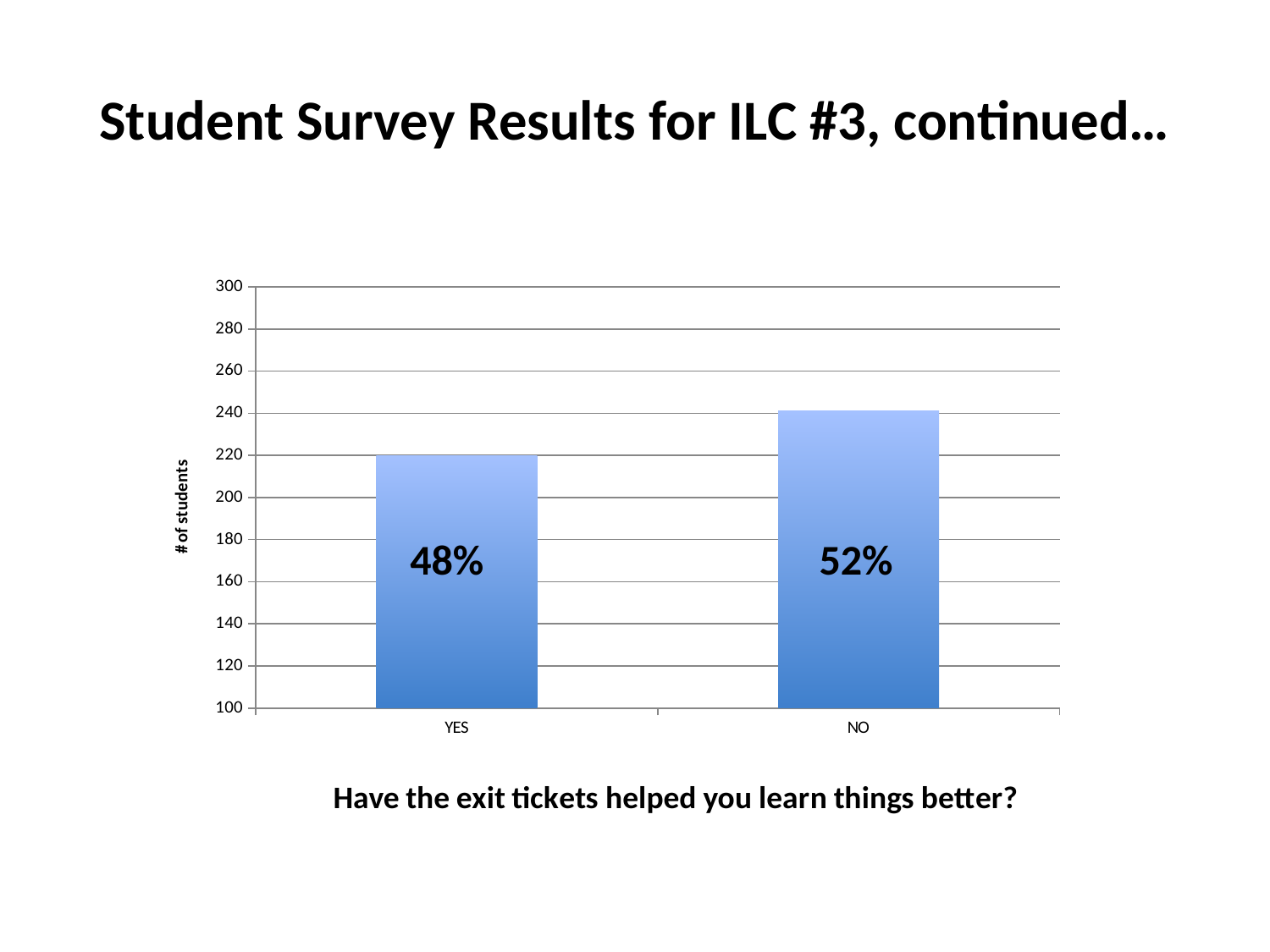
Which category has the lowest bar? YES What percentage label is shown on the YES bar? 48% Is the value for NO greater or less than 220? greater What is the title of the vertical axis? # of students What is the number of students for YES, as read from the axis? 220 What kind of chart is shown on the slide? bar chart Is the value for NO greater or less than 260? less What is the difference in percentage points between the NO label and the YES label? 4 percentage points How many categories are plotted on the chart? 2 What percentage label is shown on the NO bar? 52% Which is larger, the value for YES or the value for NO? NO Which category has the highest bar? NO